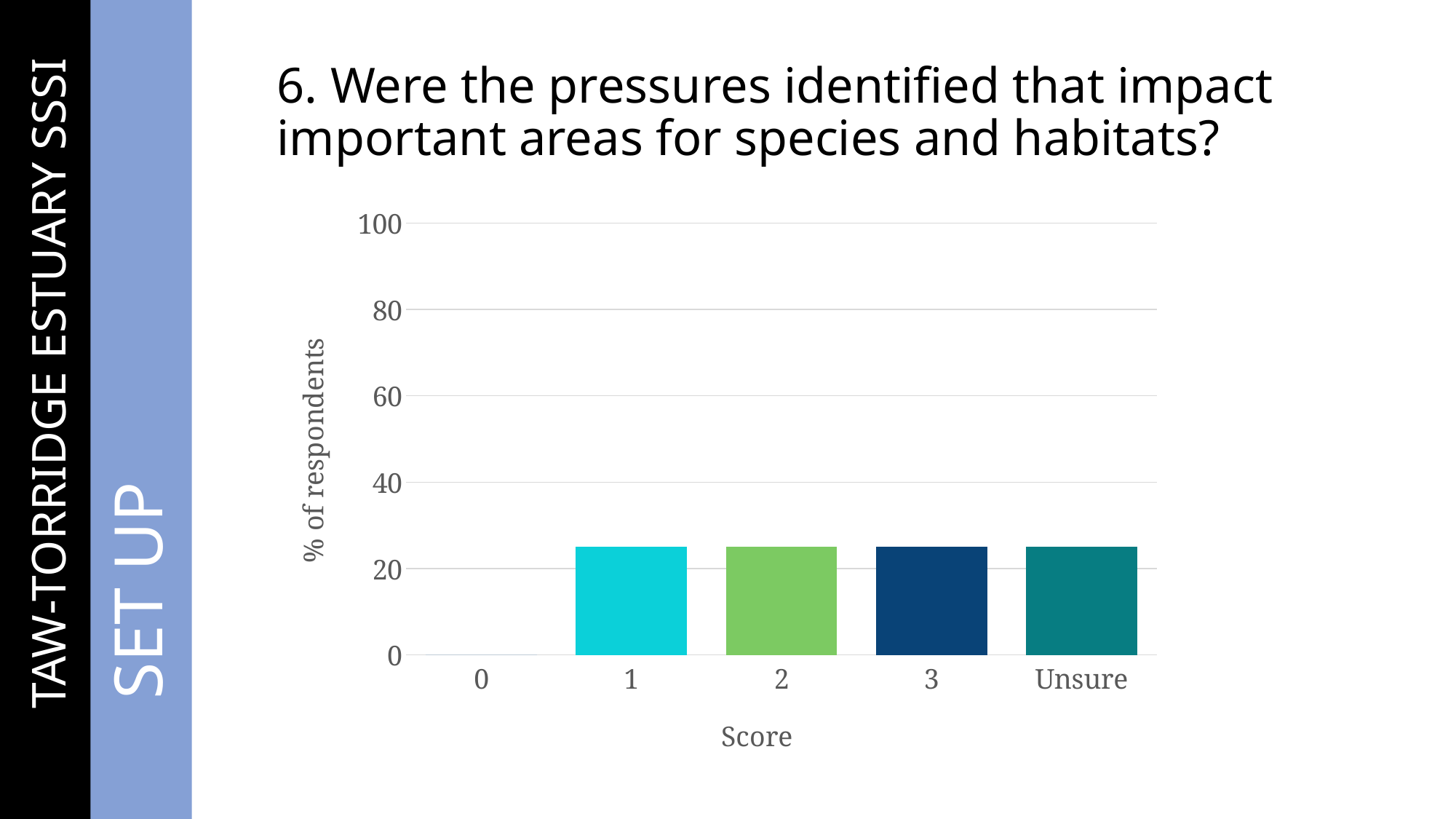
Which score category has the lowest value in the chart? 0 What is the label of the x axis of the chart? Score How many score categories are shown on the x axis of the chart? 5 Which has the larger value, score 0 or score 1? 1 Is the value for score 2 greater or less than 40? less What kind of chart is shown on the slide? bar chart What is the label of the y axis of the chart? % of respondents Is the value for Unsure greater or less than 40? less Which has the larger value, score 0 or Unsure? Unsure Is the value for score 3 greater or less than 20? greater